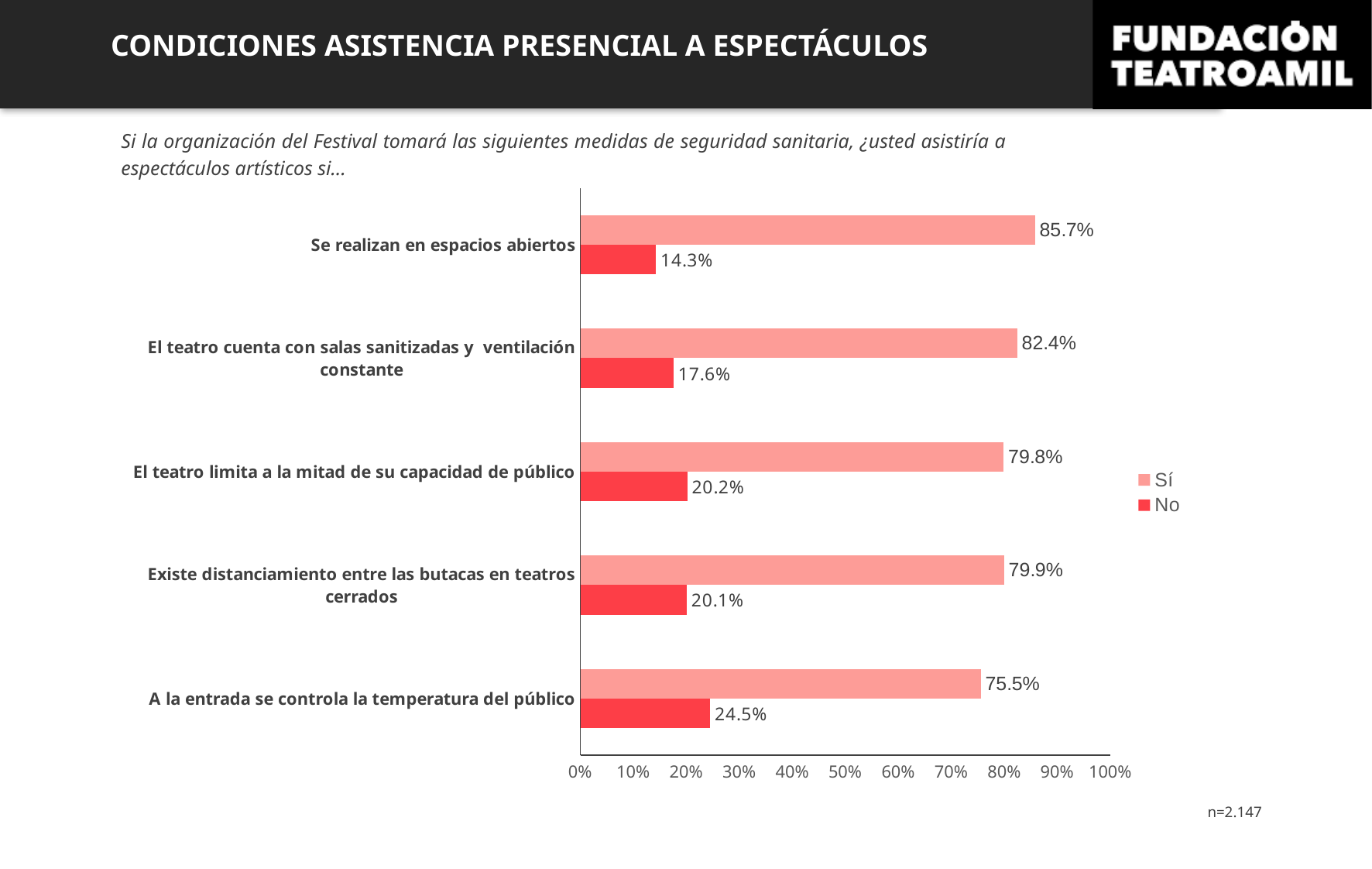
Which category has the highest 'Sí' value? Se realizan en espacios abiertos What is the sample size noted on the slide? n=2.147 What is the 'Sí' value for 'El teatro limita a la mitad de su capacidad de público'? 79.8% What kind of chart is shown on the slide? Bar chart How many series does the legend list? 2 How many categories are shown on the chart? 5 What is the 'No' value for 'A la entrada se controla la temperatura del público'? 24.5% Which is larger: the 'No' value for 'Se realizan en espacios abiertos' or the 'No' value for 'A la entrada se controla la temperatura del público'? A la entrada se controla la temperatura del público What are the two series listed in the legend? Sí and No What is the difference between the 'Sí' and 'No' values for 'El teatro cuenta con salas sanitizadas y ventilación constante'? 64.8% What is the 'Sí' value for 'Se realizan en espacios abiertos'? 85.7% Which category has the lowest 'Sí' value? A la entrada se controla la temperatura del público